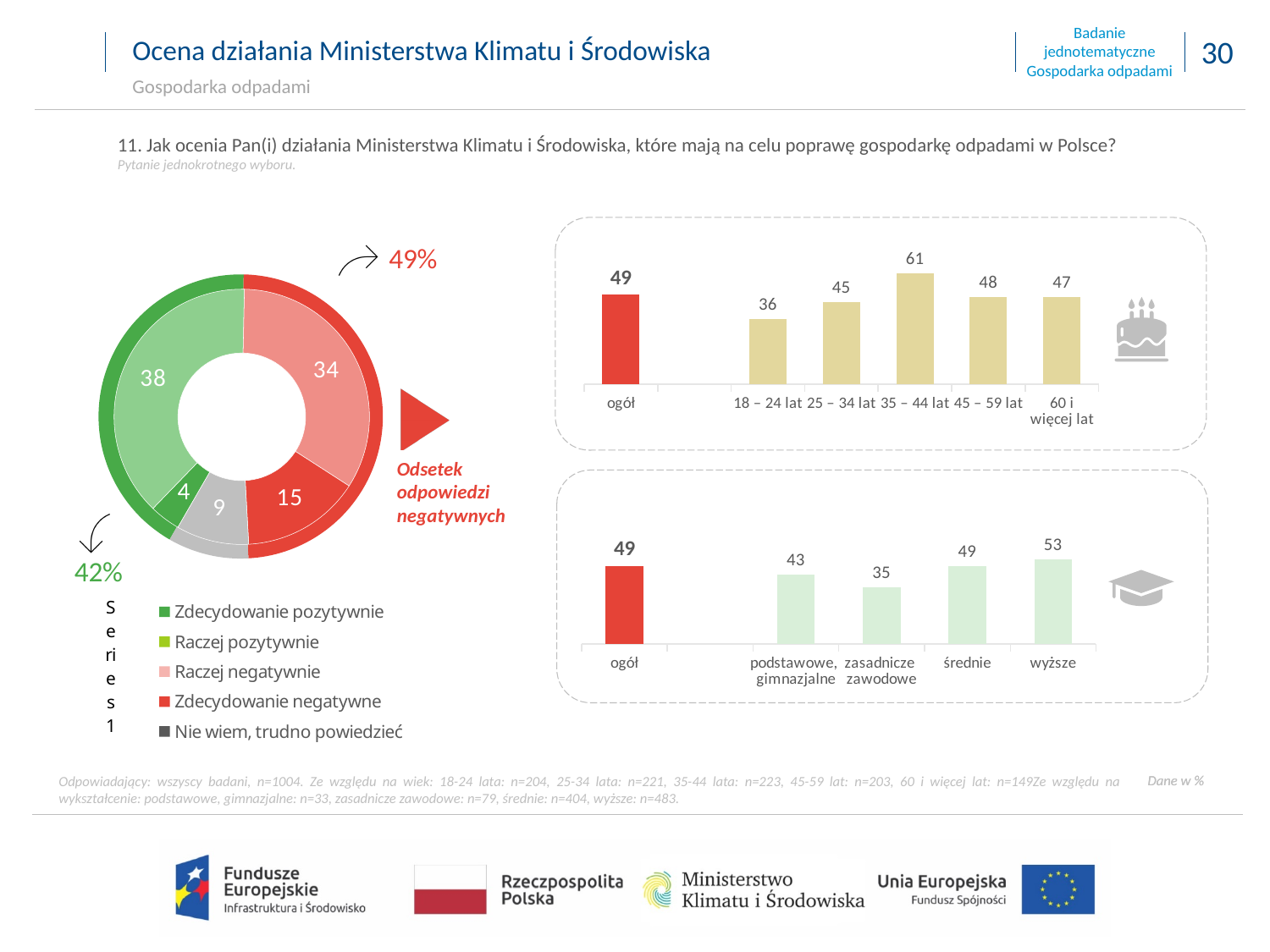
In the doughnut chart on the left, what is the value for Nie wiem, trudno powiedzieć? 9 In the education bar chart (bottom right), which education category has the lowest value? zasadnicze zawodowe In the education bar chart (bottom right), what is the value for ogół? 49 In the education bar chart (bottom right), which is larger: the value for podstawowe, gimnazjalne or the value for zasadnicze zawodowe? podstawowe, gimnazjalne How many entries does the legend of the doughnut chart on the left list? 5 In the age-group bar chart (top right), how many bars are plotted? 6 What type of chart is shown on the left side of the slide? Doughnut chart In the doughnut chart on the left, what is the value for Zdecydowanie negatywne? 15 In the education bar chart (bottom right), what is the value for wyższe? 53 In the age-group bar chart (top right), what is the value for 35 – 44 lat? 61 In the age-group bar chart (top right), what is the difference between the values for 35 – 44 lat and 18 – 24 lat? 25 In the age-group bar chart (top right), which age group has the lowest value? 18 – 24 lat